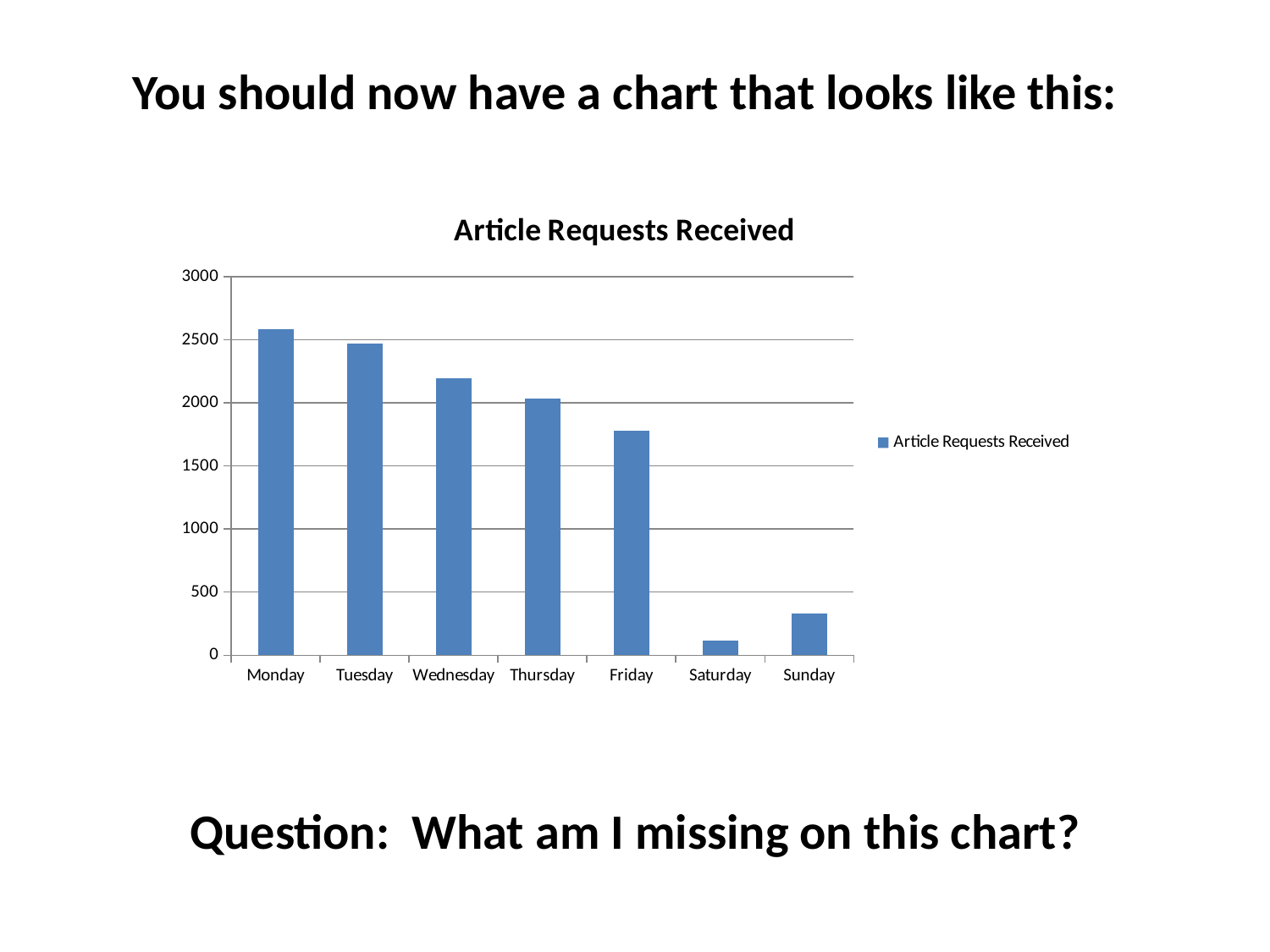
What type of chart is shown on the slide? bar chart Is the value for Sunday greater or less than 500? less How many series does the legend list? 1 Which day has the highest number of article requests received? Monday Is the value for Monday greater or less than 2500? greater What is the title of the chart? Article Requests Received How many categories are shown on the x axis of the chart? 7 Which is larger, the value for Tuesday or the value for Wednesday? Tuesday Is the value for Friday greater or less than 2000? less Which is larger, the value for Saturday or the value for Sunday? Sunday Which day has the lowest number of article requests received? Saturday Do the values rise or fall from Monday to Friday? fall